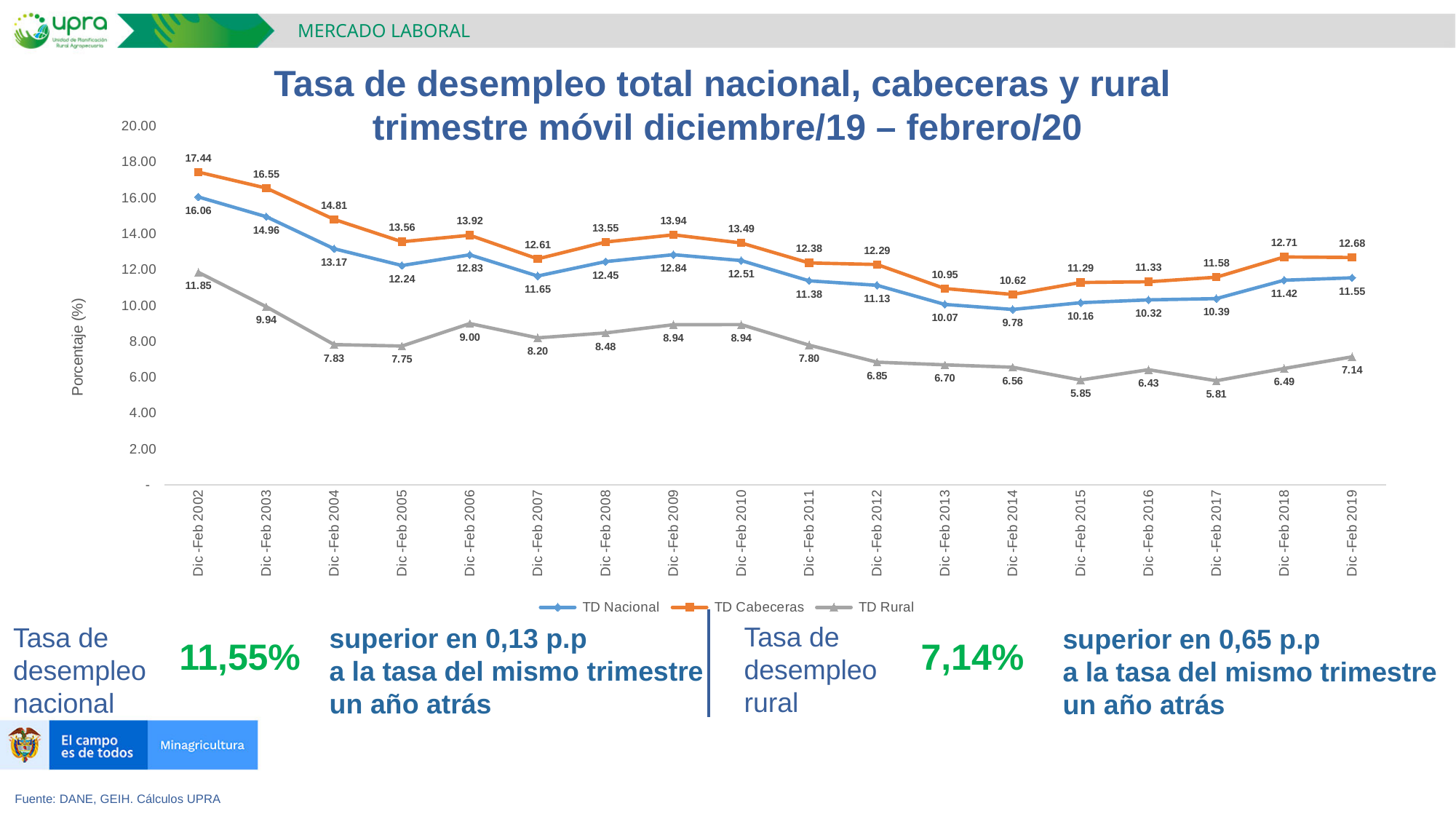
What is the difference between TD Cabeceras and TD Nacional in Dic-Feb 2019? 1.13 By how much did TD Rural fall from Dic-Feb 2002 to Dic-Feb 2019? 4.71 In which period is TD Cabeceras lowest? Dic-Feb 2014 How many series does the legend list? 3 What is the value of TD Nacional for Dic-Feb 2014? 9.78 What kind of chart is shown? Line chart How many periods are shown on the x axis? 18 Which is larger for TD Nacional: Dic-Feb 2010 or Dic-Feb 2011? Dic-Feb 2010 Does TD Cabeceras rise or fall from Dic-Feb 2002 to Dic-Feb 2005? Fall In which period is TD Rural highest? Dic-Feb 2002 What is the value of TD Rural for Dic-Feb 2019? 7.14 What is the value of TD Cabeceras for Dic-Feb 2002? 17.44